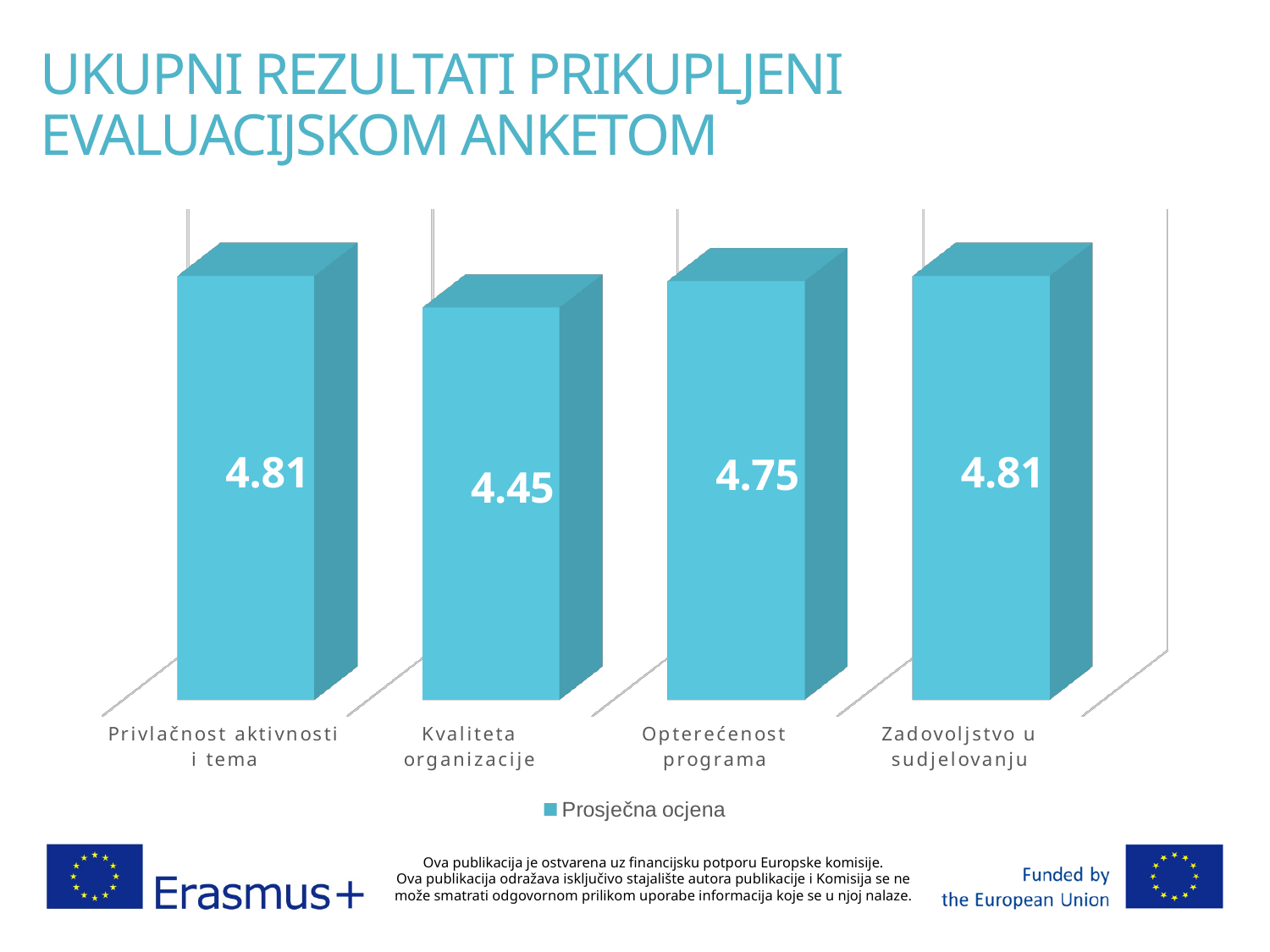
What kind of chart is shown on the slide? Bar chart What is the value for Kvaliteta organizacije? 4.45 What is the value for Zadovoljstvo u sudjelovanju? 4.81 What is the difference between the values for Privlačnost aktivnosti i tema and Kvaliteta organizacije? 0.36 What is the name of the series shown in the legend? Prosječna ocjena How many series does the legend list? 1 What is the difference between the values for Zadovoljstvo u sudjelovanju and Opterećenost programa? 0.06 How many categories are shown in the chart? 4 What is the value for Privlačnost aktivnosti i tema? 4.81 Which is larger, the value for Opterećenost programa or the value for Kvaliteta organizacije? Opterećenost programa What is the value for Opterećenost programa? 4.75 Which category has the lowest value? Kvaliteta organizacije